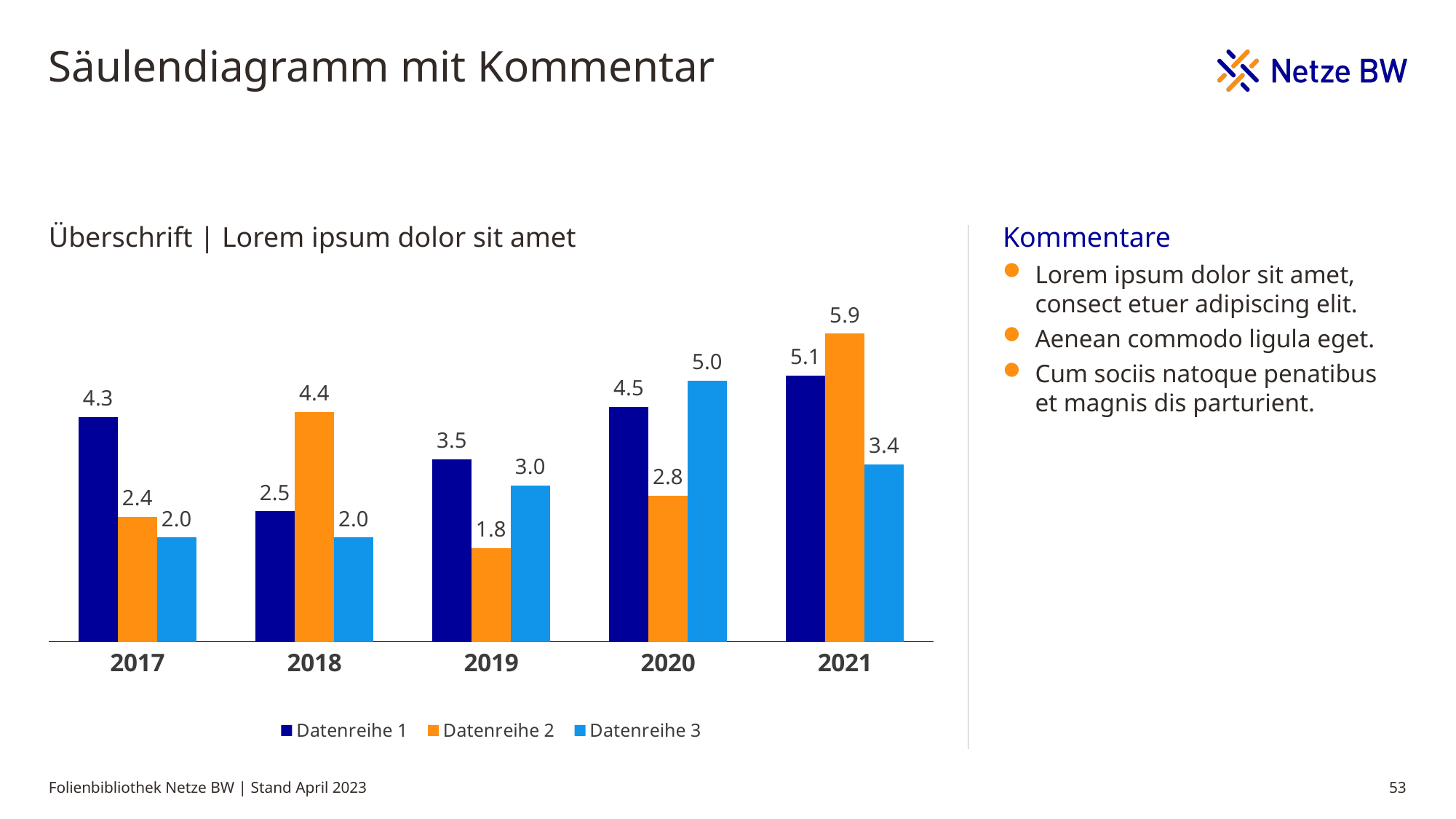
How many series does the legend list? 3 What is the value for Datenreihe 3 in 2019? 3.0 Does the value for Datenreihe 1 rise or fall from 2018 to 2021? Rise What is the difference between Datenreihe 3 in 2020 and Datenreihe 3 in 2021? 1.6 How many years are shown on the x axis? 5 What is the title of the chart? Überschrift | Lorem ipsum dolor sit amet What is the value for Datenreihe 2 in 2021? 5.9 What kind of chart is shown on the slide? Bar chart What is the value for Datenreihe 1 in 2017? 4.3 Which year has the highest value for Datenreihe 2? 2021 Which year has the lowest value for Datenreihe 1? 2018 Which is larger in 2018: Datenreihe 1 or Datenreihe 2? Datenreihe 2